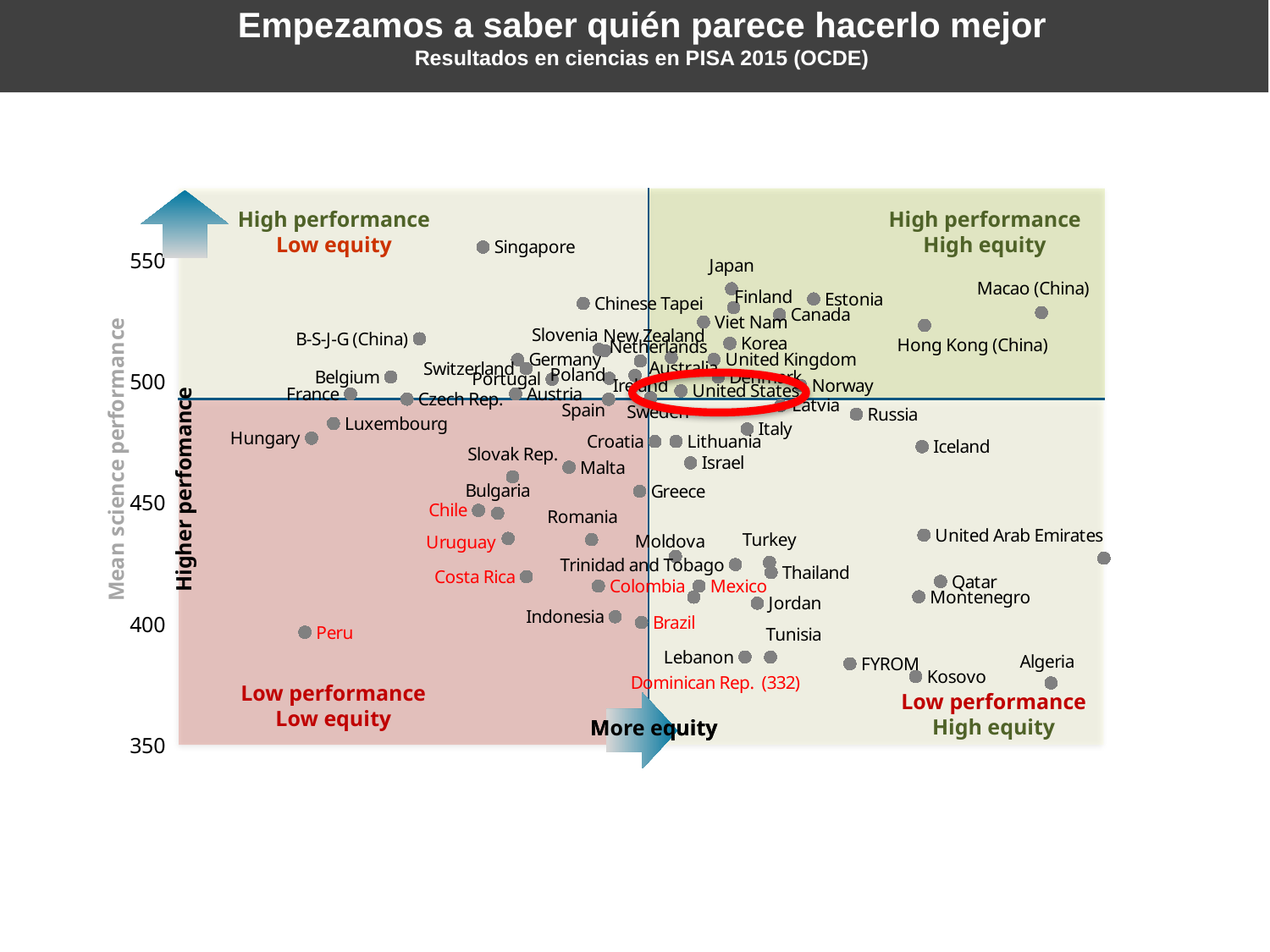
Is the mean science performance for Kosovo greater or less than 400? less Which country has the lowest mean science performance on the chart? Dominican Rep. What mean science performance value is printed for the Dominican Rep.? 332 Which country has the highest mean science performance on the chart? Singapore Is the mean science performance for Singapore greater or less than 550? greater Is the mean science performance for Macao (China) greater or less than 500? greater Which has a higher mean science performance, Japan or Iceland? Japan What kind of chart is shown on the slide? scatter plot What is the label of the vertical axis of the chart? Mean science performance Which country's point is circled in red on the chart? United States